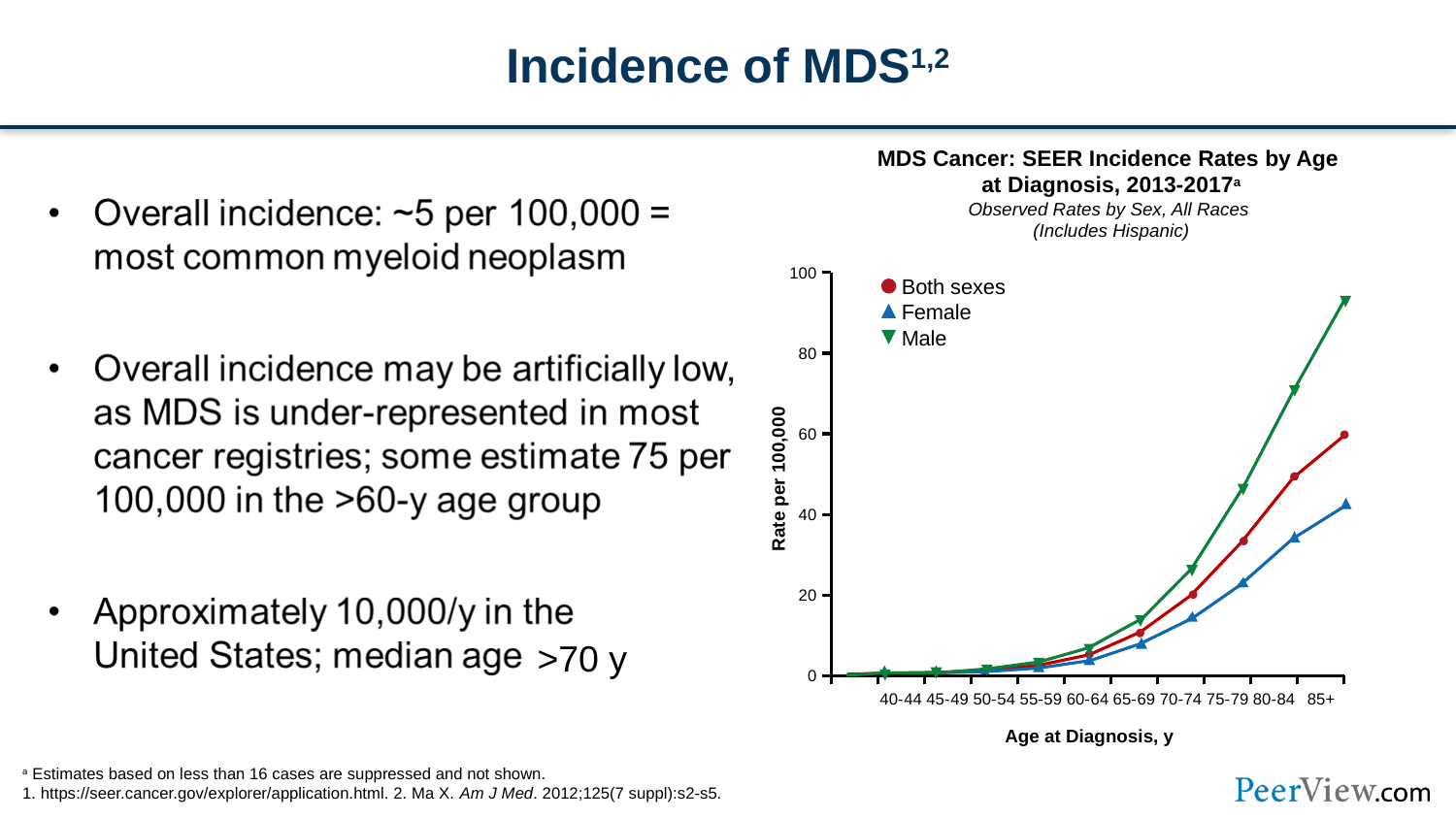
Is the Female rate for the 80-84 age group greater or less than 40? less For which age group is the Male rate highest? 85+ In the 75-79 age group, which is larger, the Male rate or the Female rate? Male Which series has the highest rate in the 85+ age group? Male What kind of chart is shown on the slide? line chart Is the Male rate for the 85+ age group greater or less than 80? greater Is the Both sexes rate for the 80-84 age group greater or less than 40? greater What is the title of the y axis? Rate per 100,000 How many age groups are shown on the x axis? 10 How many series does the legend list? 3 Do the incidence rates rise or fall as age at diagnosis increases? rise Which series has the lowest rate in the 85+ age group? Female